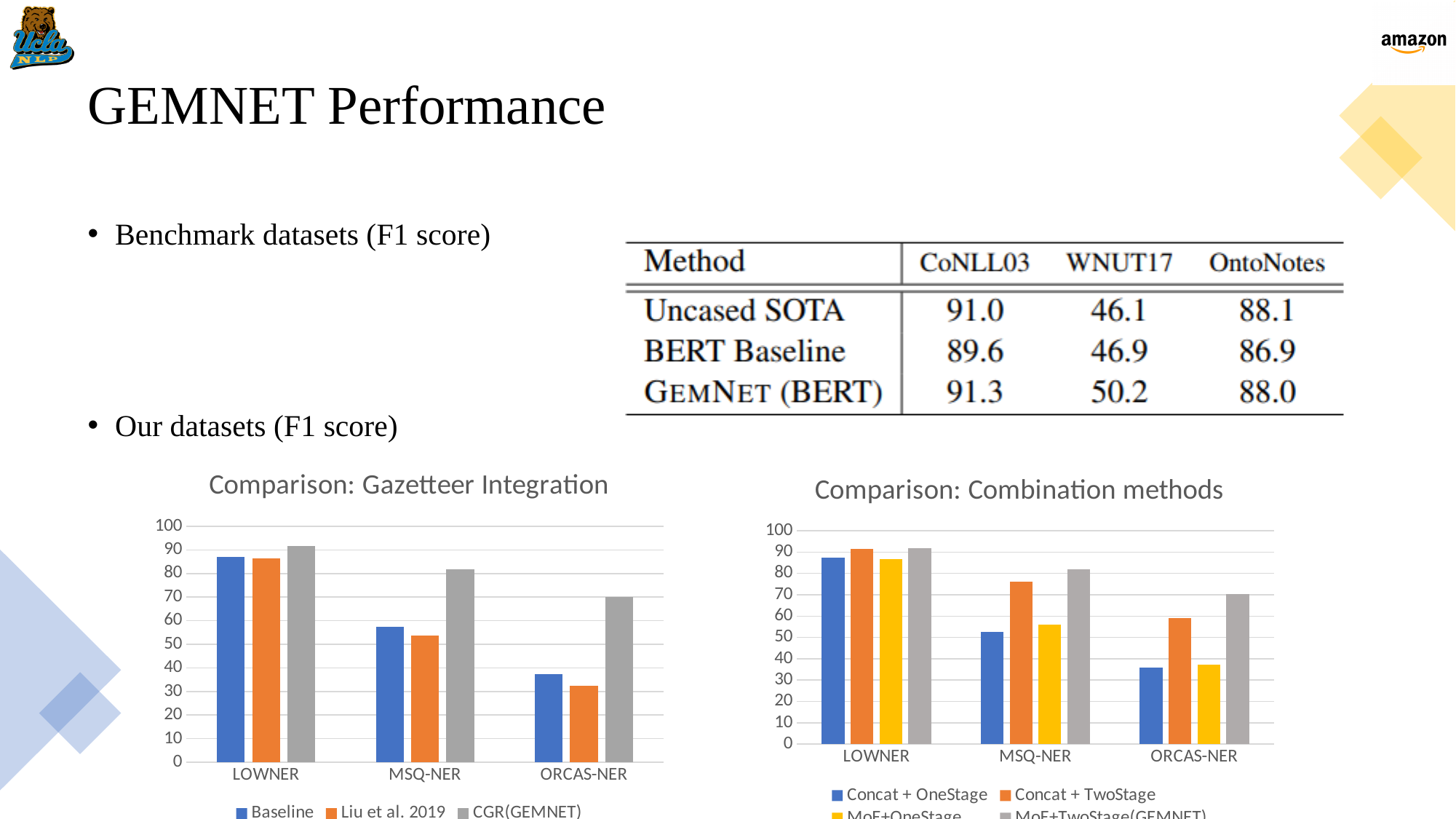
What kind of chart is the 'Comparison: Gazetteer Integration' chart? bar chart In the 'Comparison: Gazetteer Integration' chart, is the Liu et al. 2019 value for ORCAS-NER greater or less than 40? less In the 'Comparison: Gazetteer Integration' chart, which is larger for MSQ-NER: Baseline or CGR(GEMNET)? CGR(GEMNET) How many series does the legend of the 'Comparison: Combination methods' chart list? 4 In the 'Comparison: Combination methods' chart, which is larger for ORCAS-NER: Concat + TwoStage or MoE+OneStage? Concat + TwoStage In the 'Comparison: Combination methods' chart, which series has the highest value for ORCAS-NER? MoE+TwoStage(GEMNET) How many categories are shown on the x axis of the 'Comparison: Gazetteer Integration' chart? 3 In the 'Comparison: Combination methods' chart, is the Concat + OneStage value for MSQ-NER greater or less than 60? less How many series does the legend of the 'Comparison: Gazetteer Integration' chart list? 3 In the 'Comparison: Gazetteer Integration' chart, is the CGR(GEMNET) value for MSQ-NER greater or less than 70? greater In the 'Comparison: Gazetteer Integration' chart, do the CGR(GEMNET) values rise or fall from LOWNER to ORCAS-NER? fall In the 'Comparison: Gazetteer Integration' chart, which category has the lowest Baseline value? ORCAS-NER